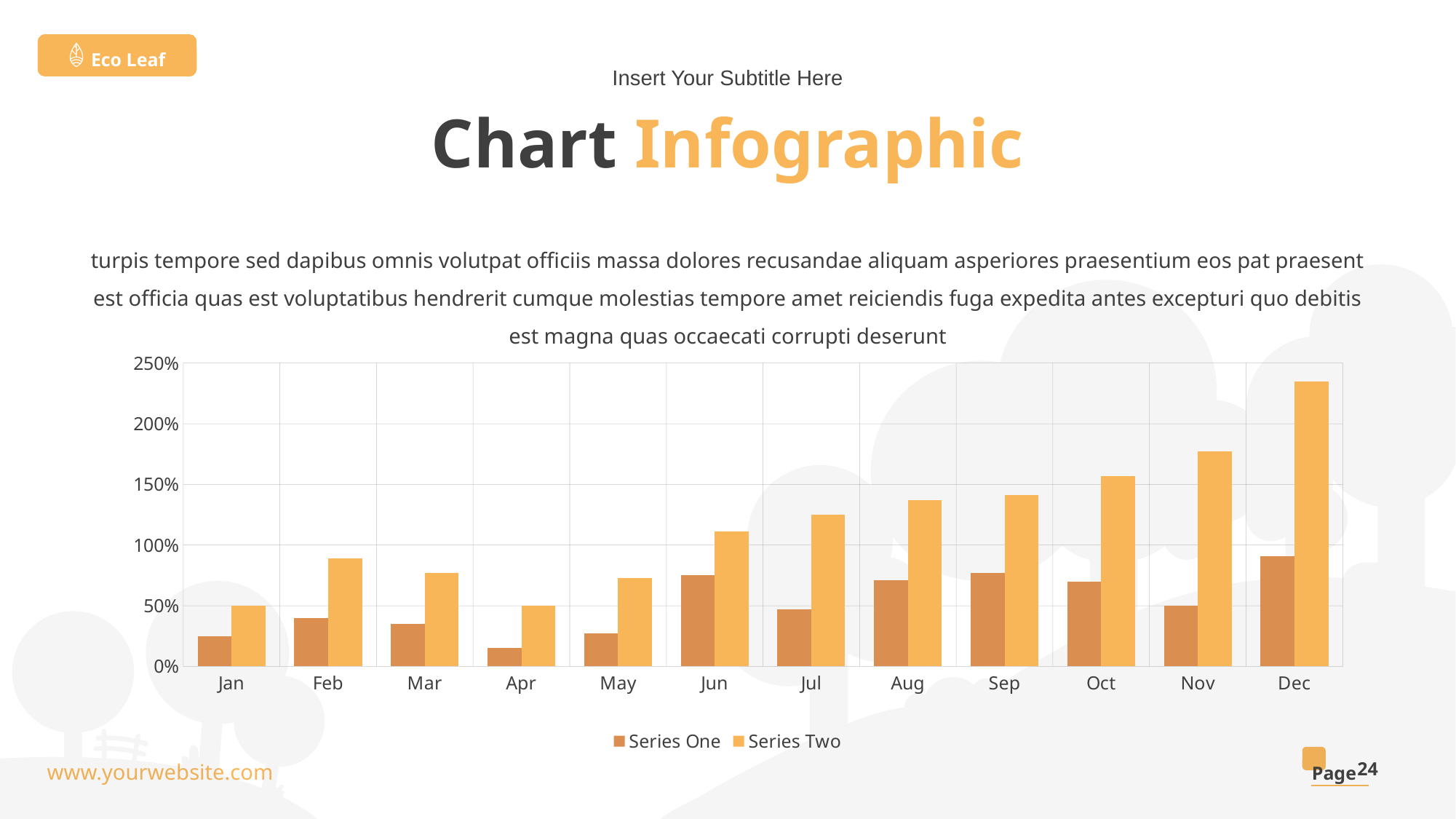
Which month has the highest Series Two value? Dec Is the Series Two value for Oct greater or less than 150%? greater Which month has the lowest Series One value? Apr Which month has the lowest Series Two value? Jan and Apr (tied) What are the two legend entries of the chart? Series One, Series Two Is the Series Two value for Dec greater or less than 200%? greater What kind of chart is shown on the slide? bar chart Which is larger in Aug, Series One or Series Two? Series Two Is the Series One value for Jun greater or less than 100%? less How many series does the legend list? 2 Does the Series Two value generally rise or fall from Jun to Dec? rise How many categories are shown on the x axis? 12